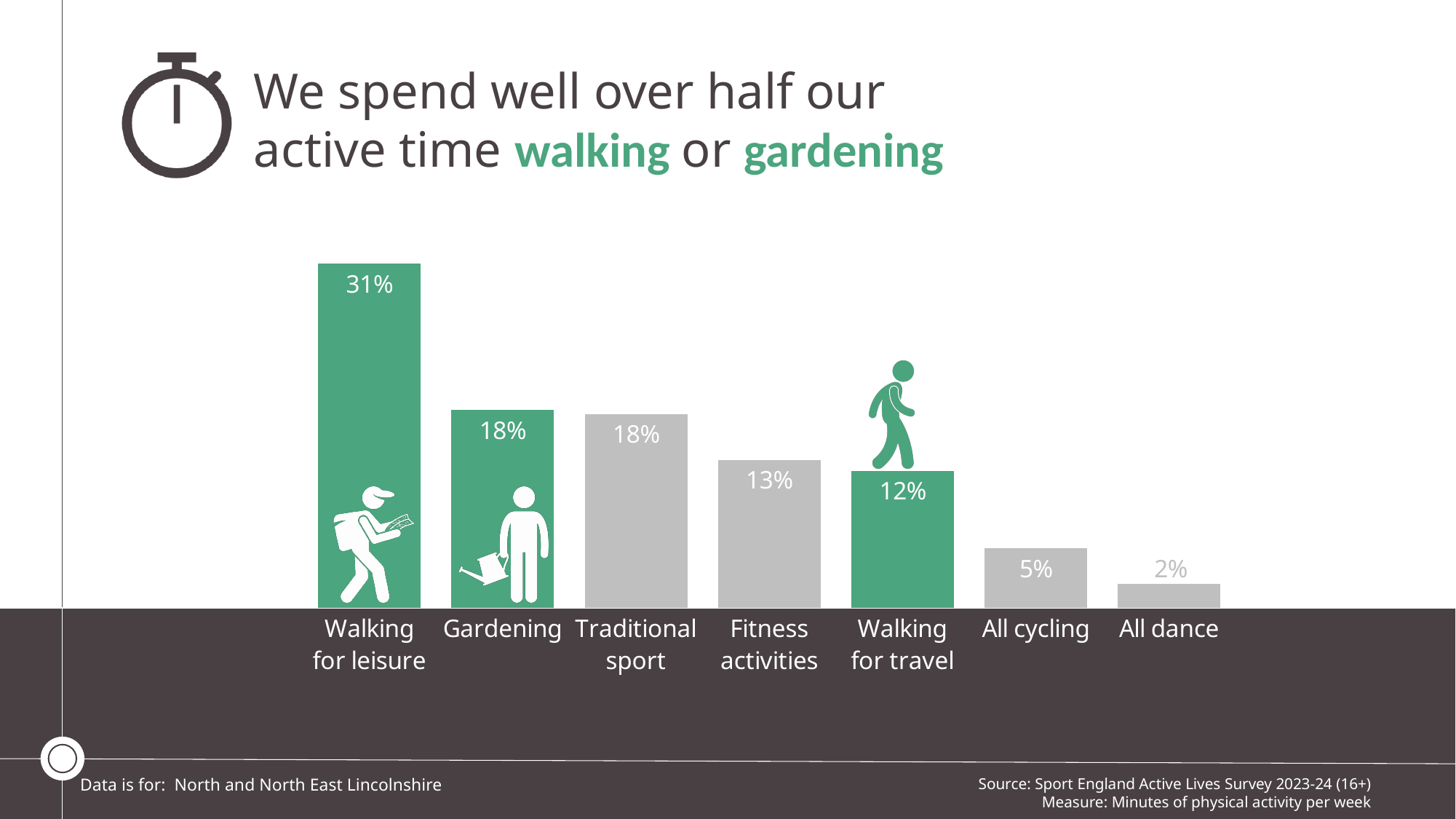
Which category has the lowest value? All dance What is the value shown for Gardening? 18% What type of chart is shown on the slide? Bar chart How many categories are shown in the chart? 7 What is the difference between Walking for leisure and Walking for travel? 19% Which category has the highest value? Walking for leisure Which is larger, Fitness activities or Walking for travel? Fitness activities What percentage of active time is spent walking for leisure? 31% What is the value shown for Fitness activities? 13% What is the value shown for All dance? 2% What is the difference between Fitness activities and All cycling? 8% Which categories are shown with green bars? Walking for leisure, Gardening, Walking for travel